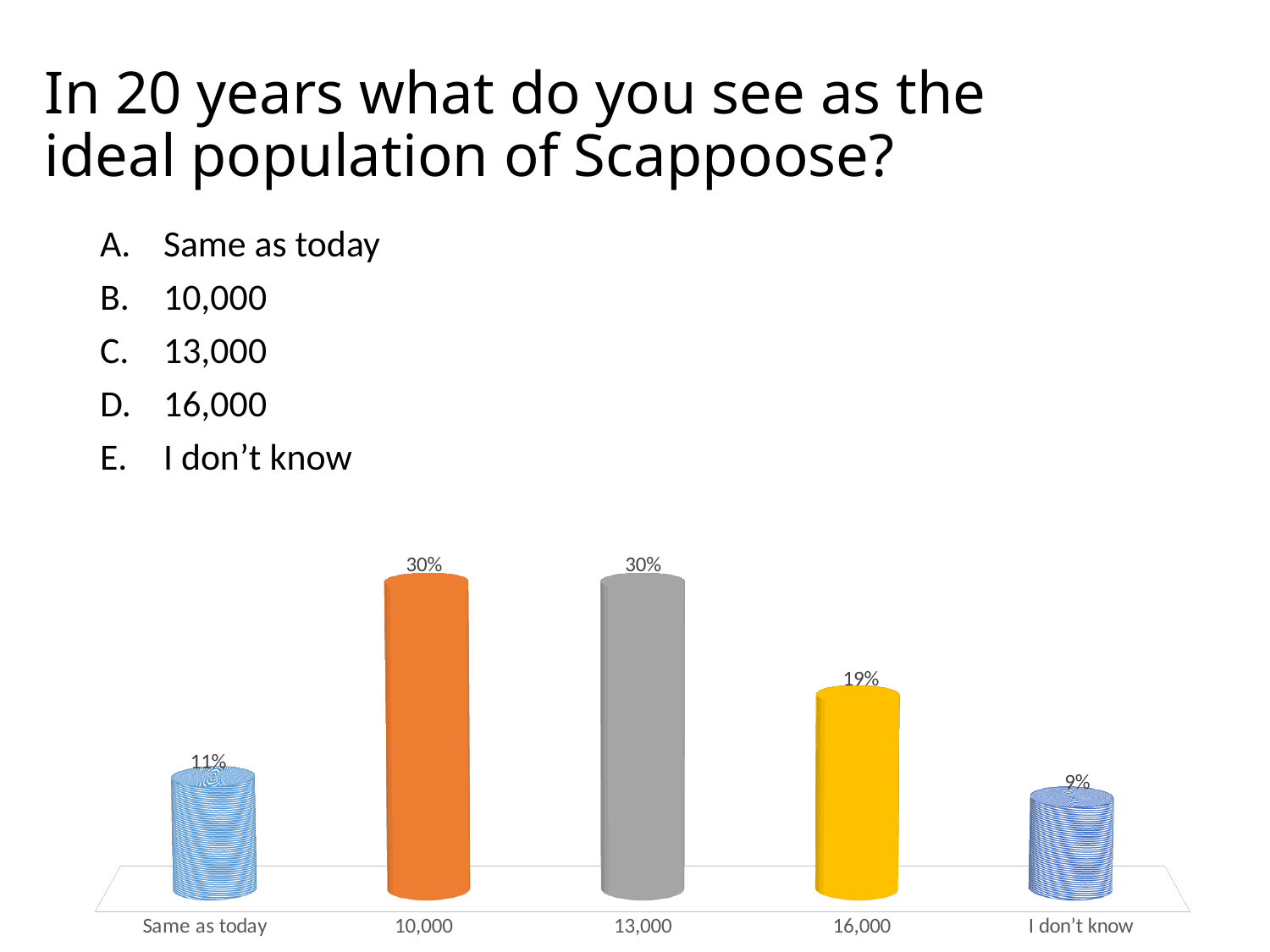
How many response categories are shown in the chart? 5 What percentage of respondents chose "I don't know"? 9% What percentage of respondents chose 16,000? 19% Which response option has the lowest percentage? I don't know What is the difference in percentage points between the 10,000 option and the 16,000 option? 11 What percentage of respondents chose 13,000? 30% What is the difference in percentage points between "Same as today" and "I don't know"? 2 What percentage of respondents chose "Same as today"? 11% Which has a higher percentage, 13,000 or 16,000? 13,000 What type of chart is shown on the slide? Bar chart What percentage of respondents chose 10,000? 30% Which has a higher percentage, 16,000 or "Same as today"? 16,000